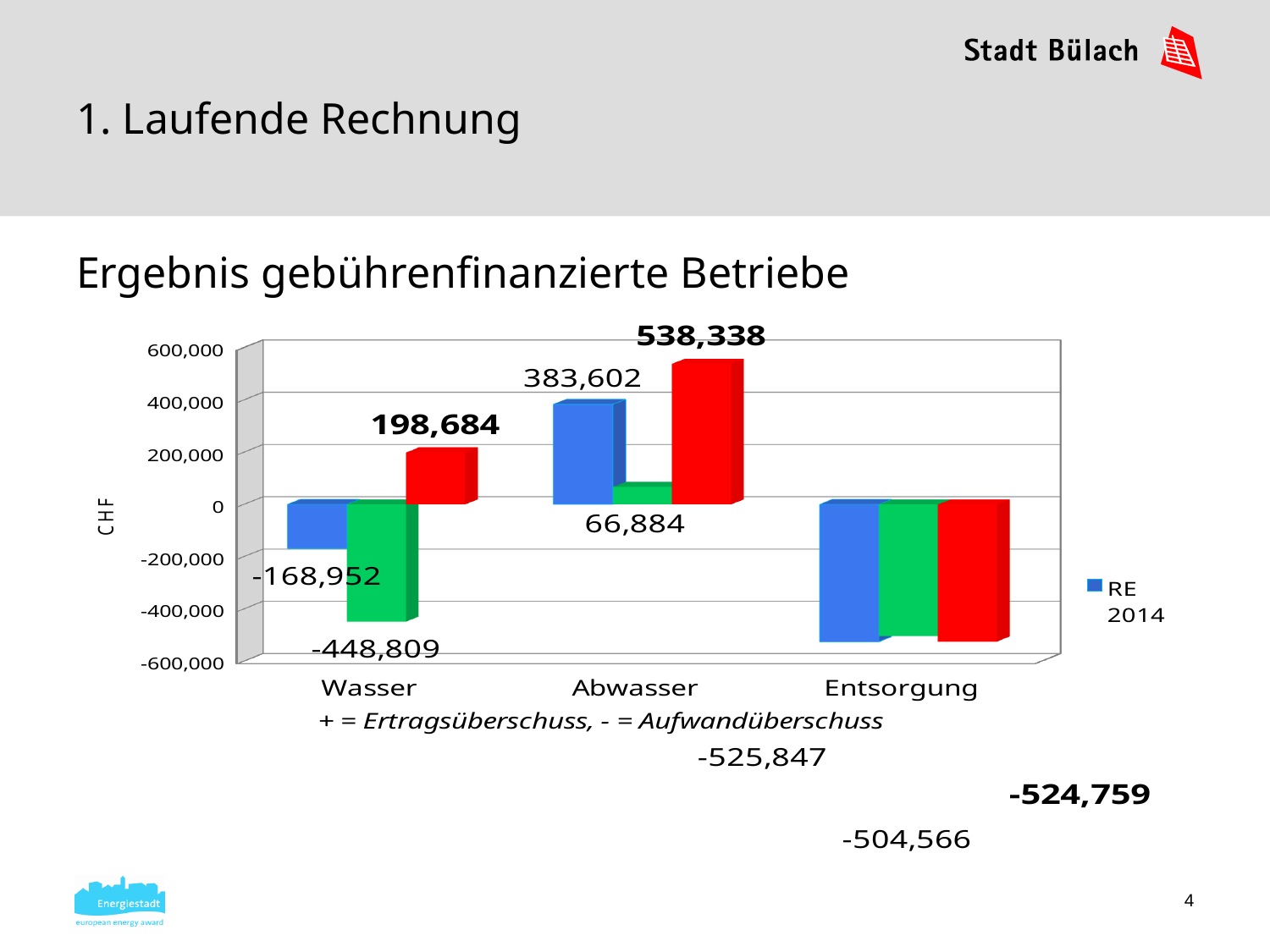
What is the RE 2014 value for Wasser? -168,952 What is the value of the green bar for Abwasser? 66,884 For Wasser, which is larger: the RE 2014 value or the green bar value? RE 2014 How many categories are shown on the x axis? 3 Is the RE 2014 value for Entsorgung greater or less than -400,000? less What is the value of the red bar for Abwasser? 538,338 What label is shown on the vertical axis? CHF What is the value of the green bar for Wasser? -448,809 What is the difference between the red bar and the RE 2014 bar for Abwasser? 154,736 Which category has the highest RE 2014 value? Abwasser What is the value of the red bar for Wasser? 198,684 What is the RE 2014 value for Abwasser? 383,602